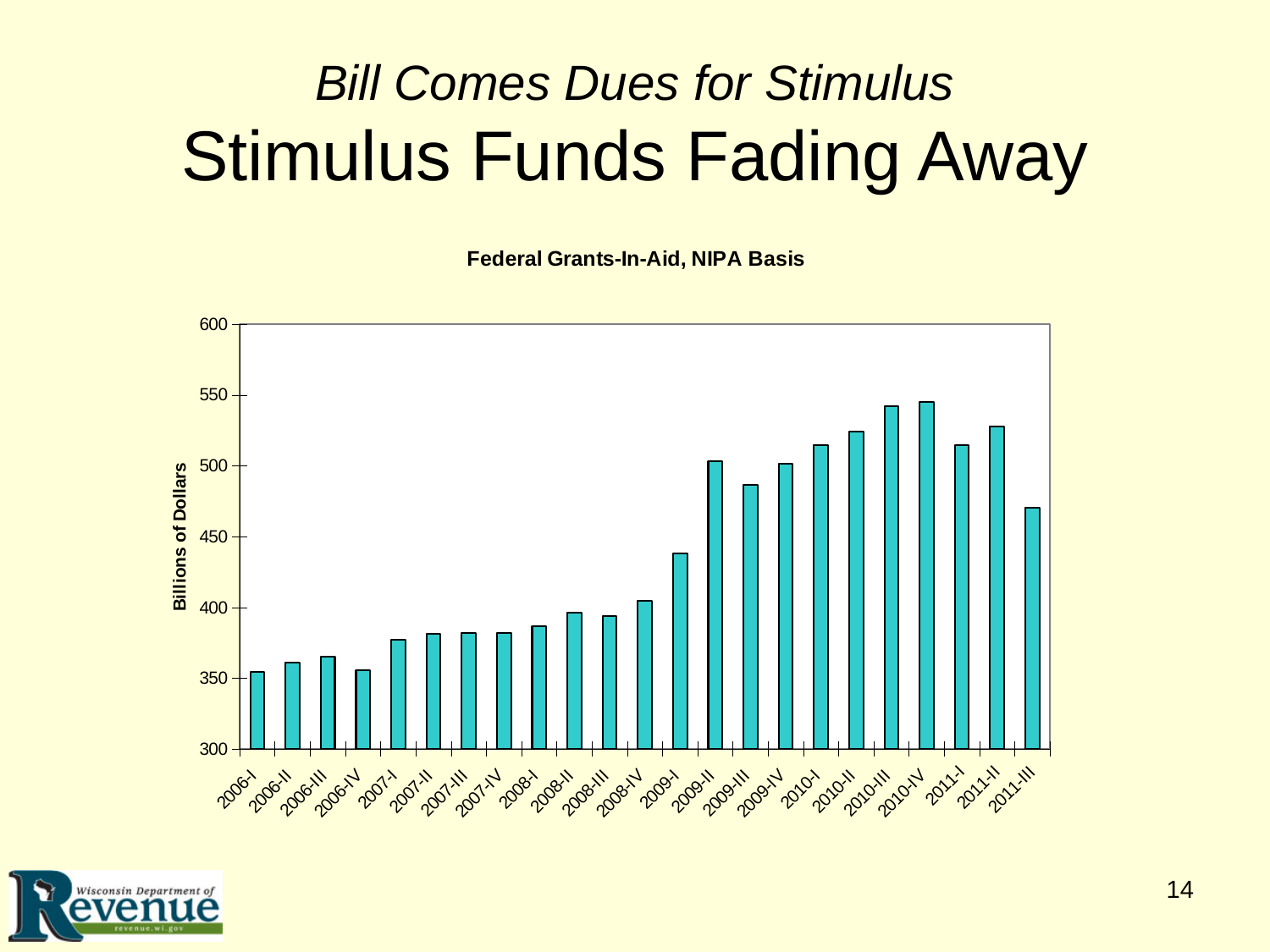
Which is larger, the value for 2006-I or the value for 2009-I? 2009-I Is the value for 2011-III greater or less than 450? greater What is the title of the chart? Federal Grants-In-Aid, NIPA Basis Is the value for 2010-IV greater or less than 500? greater Is the value for 2009-I greater or less than 450? less What kind of chart is shown on the slide? bar chart What is the label on the vertical axis of the chart? Billions of Dollars Which is larger, the value for 2010-IV or the value for 2011-III? 2010-IV How many quarters (bars) are plotted in the Federal Grants-In-Aid chart? 23 Do the values generally rise or fall from 2006-I to 2010-IV? rise